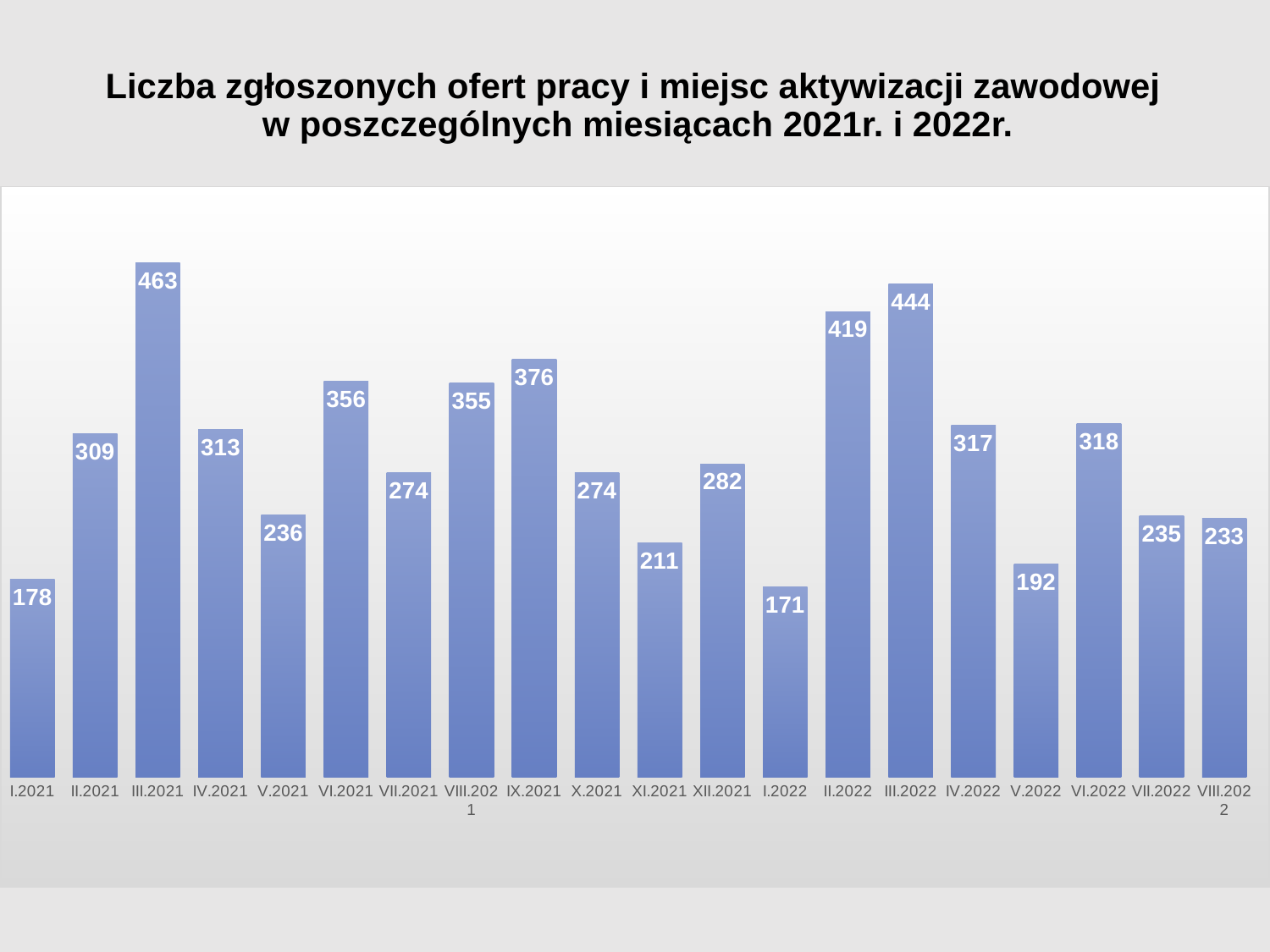
What is the value for VIII.2022? 233 What kind of chart is shown on the slide? Bar chart How many months are shown on the chart? 20 Which is larger, the value for VI.2021 or the value for IX.2021? IX.2021 What is the title of the chart? Liczba zgłoszonych ofert pracy i miejsc aktywizacji zawodowej w poszczególnych miesiącach 2021r. i 2022r. What is the difference between the values for III.2021 and I.2021? 285 What is the difference between the values for III.2022 and II.2022? 25 What is the value for I.2022? 171 What is the value for III.2021? 463 Which is larger, the value for V.2022 or the value for XI.2021? XI.2021 Which month has the lowest value? I.2022 Which month has the highest value? III.2021